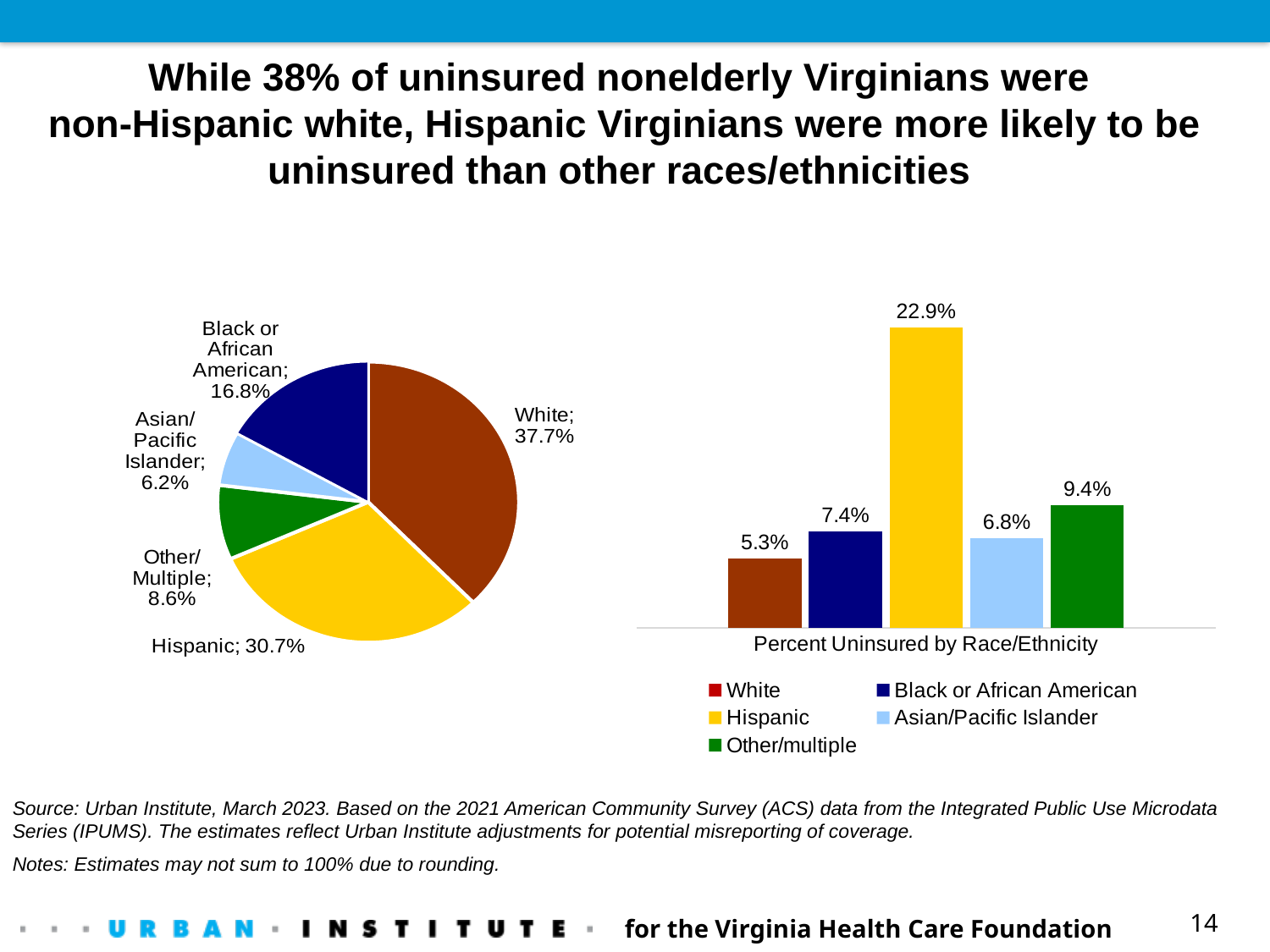
In the pie chart on the left, which category has the smallest slice? Asian/Pacific Islander In the bar chart on the right, what is the difference between the percent uninsured for Hispanic and for Other/multiple? 13.5% In the bar chart on the right, which race/ethnicity has the lowest percent uninsured? White What kind of chart is on the left side of the slide? Pie chart In the bar chart on the right, what is the percent uninsured for White Virginians? 5.3% In the pie chart on the left, which category has the largest slice? White In the bar chart on the right, which race/ethnicity has the highest percent uninsured? Hispanic In the bar chart on the right, what is the percent uninsured for Hispanic Virginians? 22.9% How many series does the legend of the bar chart on the right list? 5 In the bar chart on the right, which is larger: the percent uninsured for Black or African American or for Asian/Pacific Islander? Black or African American In the pie chart on the left, what share is labeled for Hispanic? 30.7% How many slices does the pie chart on the left have? 5